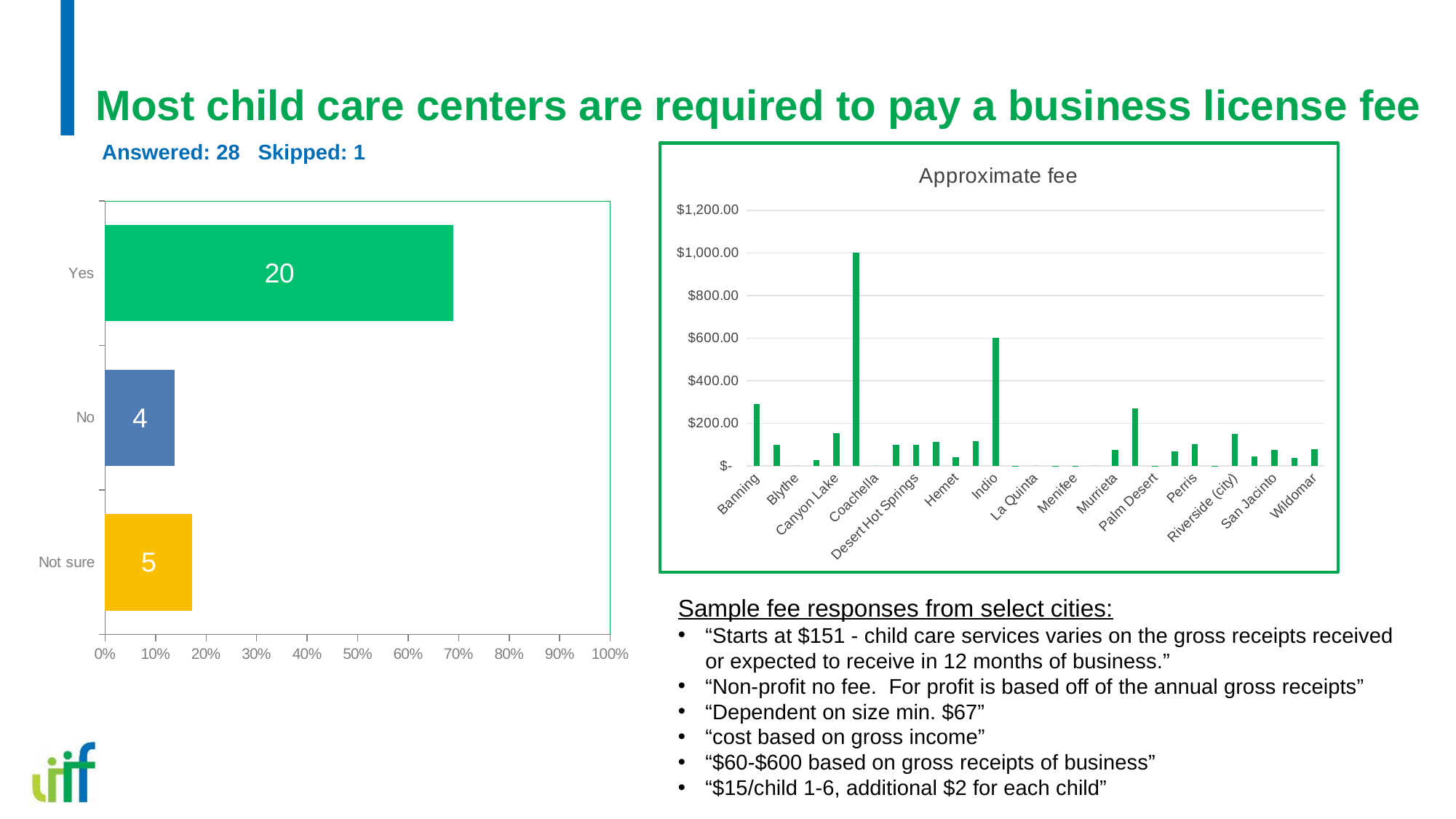
On the Approximate fee chart, is the value for Blythe greater or less than $200.00? less On the left chart, what value is shown for Yes? 20 What is the title of the chart on the right? Approximate fee On the left chart, how many categories are shown? 3 On the left chart, what is the difference between the Yes and No values? 16 On the left chart, what value is shown for Not sure? 5 What kind of chart is the left chart? bar chart On the left chart, which category has the highest value? Yes On the left chart, which category has the lowest value? No On the Approximate fee chart, is the value for Banning greater or less than $200.00? greater On the Approximate fee chart, is the value for Indio greater or less than $400.00? greater